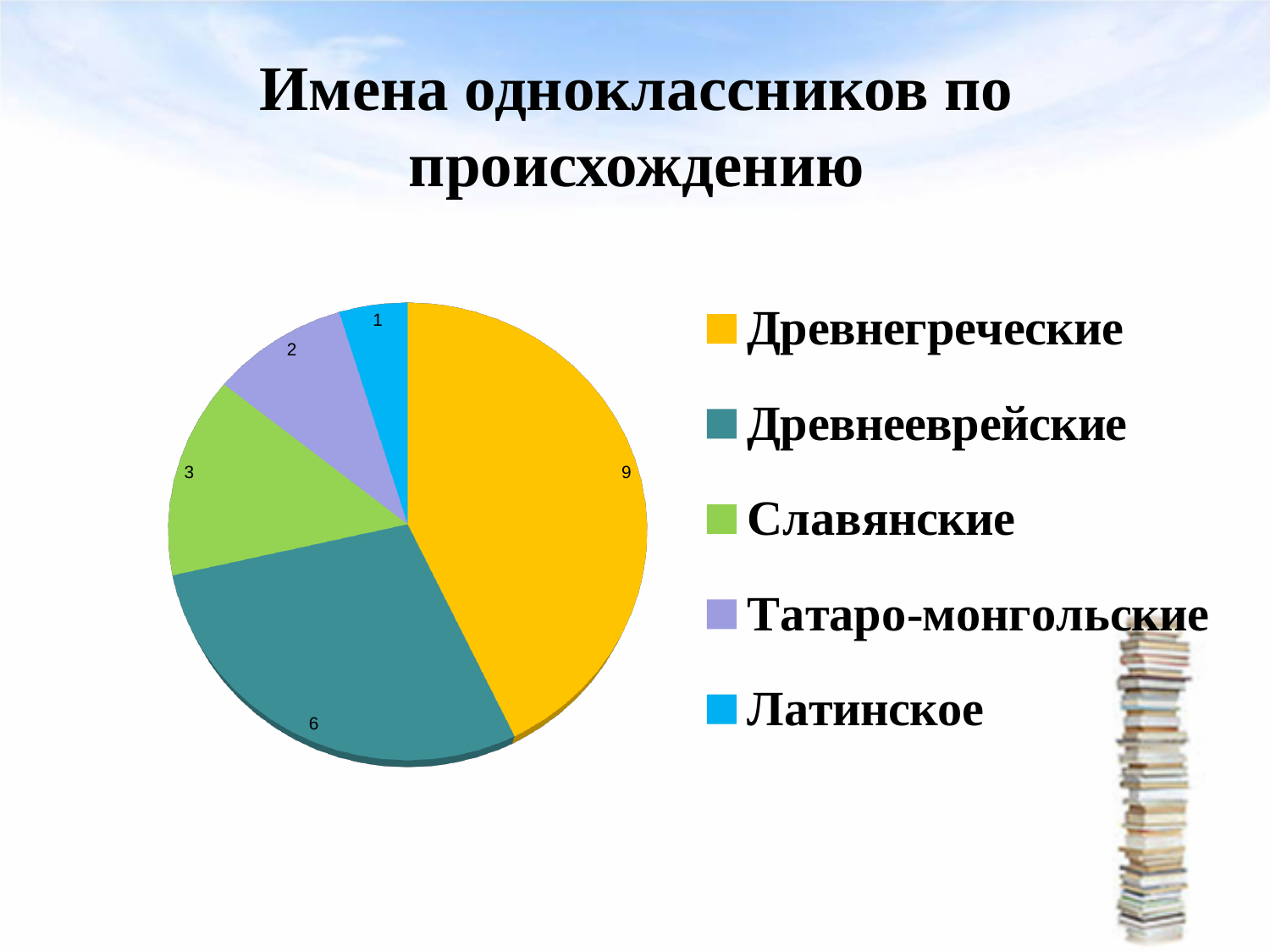
What is the value for Латинское in the pie chart? 1 What type of chart is shown on the slide? pie chart How many categories does the pie chart have? 5 What is the value for Древнегреческие in the pie chart? 9 What is the value for Славянские in the pie chart? 3 Which category has the largest slice in the pie chart? Древнегреческие What is the value for Древнееврейские in the pie chart? 6 What is the title of the chart on the slide? Имена одноклассников по происхождению What is the difference between the values for Древнегреческие and Древнееврейские? 3 What is the value for Татаро-монгольские in the pie chart? 2 Which category has the smallest slice in the pie chart? Латинское Which is larger, the value for Славянские or the value for Татаро-монгольские? Славянские